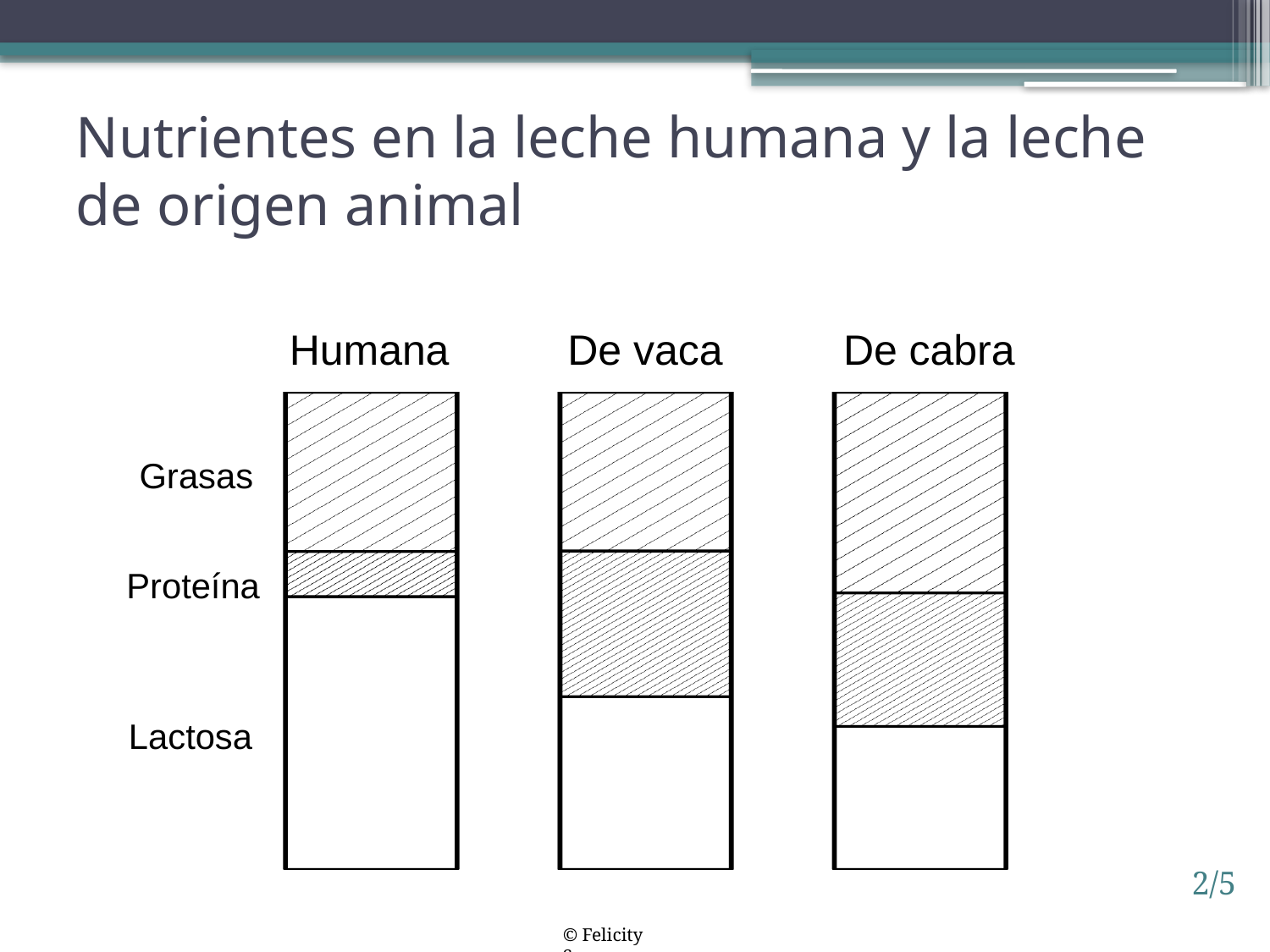
What kind of chart is shown on the slide? Stacked bar chart Which milk has the largest Lactosa segment? Humana Which milk has the smallest Lactosa segment? De cabra What is the title of the slide containing the chart? Nutrientes en la leche humana y la leche de origen animal Which has the larger Lactosa segment, Humana or De cabra? Humana Which milk has the largest Grasas segment? De cabra Which has the larger Grasas segment, Humana or De cabra? De cabra Which nutrient segment is at the top of each bar? Grasas How many types of milk (bars) are shown in the chart? 3 How many nutrient components are labelled for the bars? 3 Which has the larger Proteína segment, Humana or De vaca? De vaca Which milk has the smallest Proteína segment? Humana